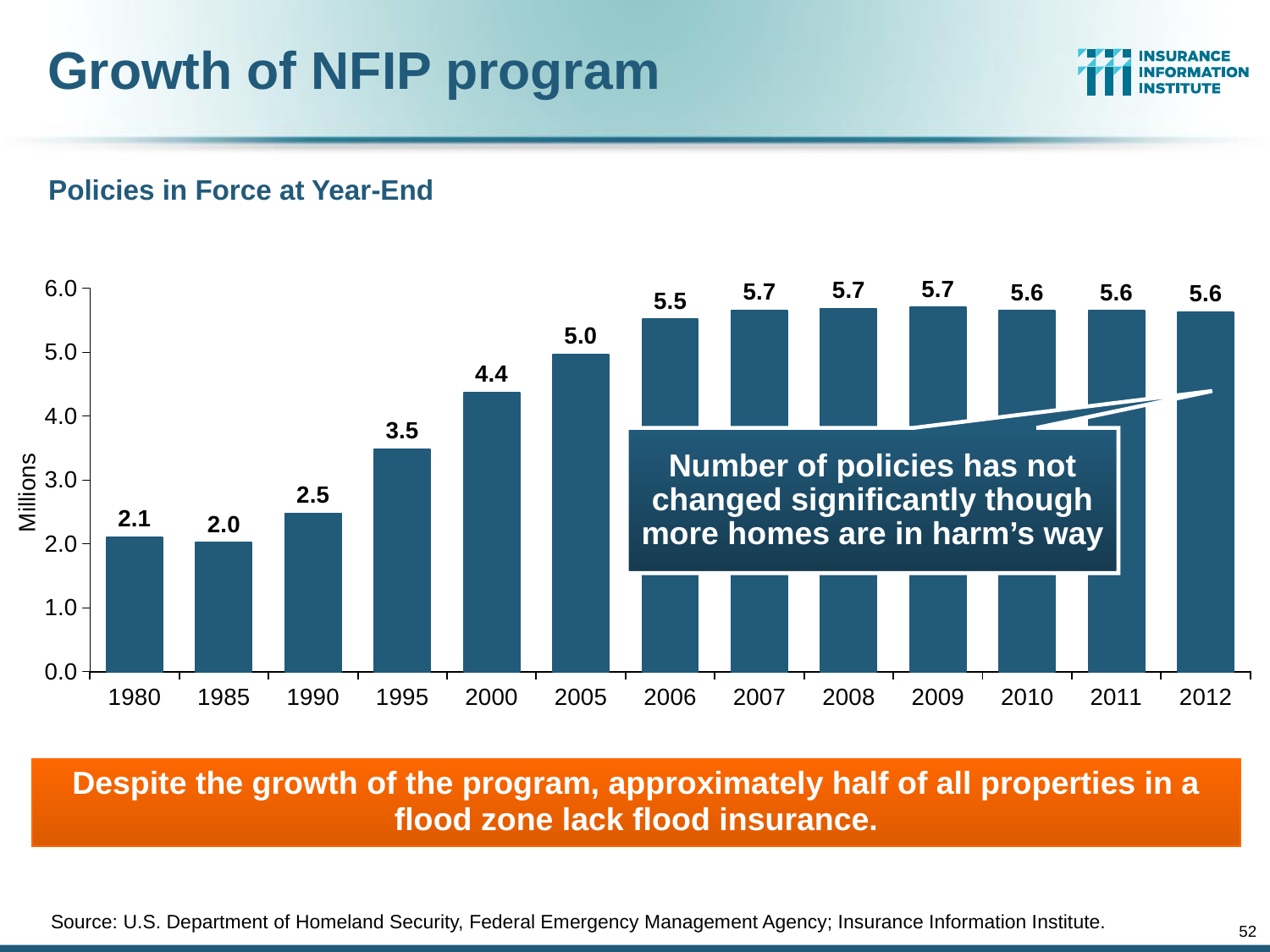
What is the value for 2012? 5.6 What is the difference between the values for 2005 and 1980? 2.9 What kind of chart is this? bar chart What is the value for 1985? 2.0 Is the value for 2005 greater or less than 4.0? greater What is the value for 2000? 4.4 What is the label on the y axis? Millions What is the title of the chart? Policies in Force at Year-End Which year has the lowest value? 1985 How many years are shown on the x axis? 13 Do the values rise or fall from 1985 to 2007? rise Which is larger, the value for 1995 or the value for 2006? 2006